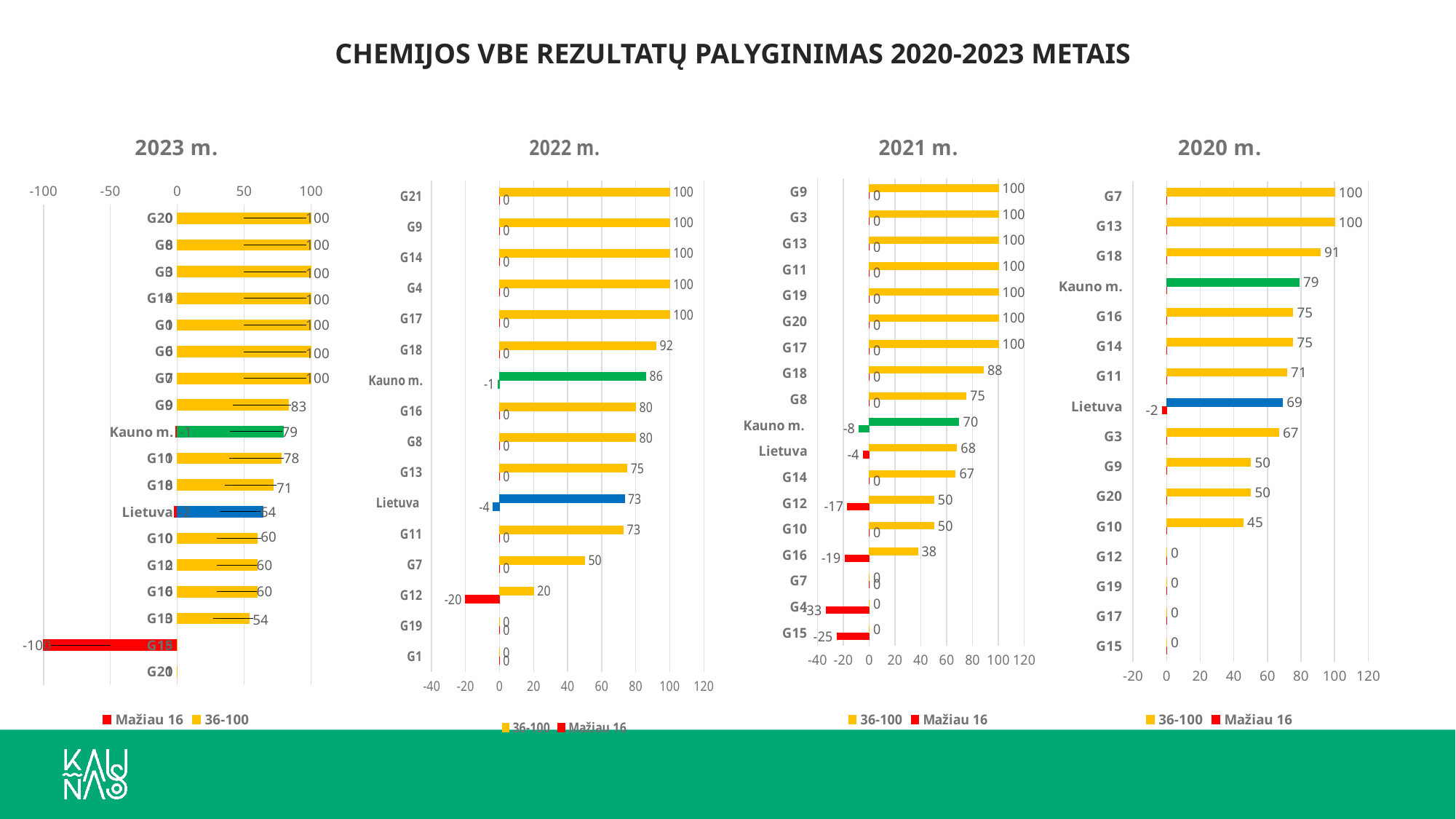
In the 2022 m. chart, which category has the lowest negative (Mažiau 16) value? G12 In the 2021 m. chart, what is the value for G16? 38 In the 2022 m. chart, what is the value for Kauno m.? 86 How many series does the legend of the 2020 m. chart list? 2 In the 2020 m. chart, what is the value for Lietuva? 69 In the 2021 m. chart, what is the negative (Mažiau 16) value shown for G4? -33 In the 2020 m. chart, what is the value for Kauno m.? 79 In the 2021 m. chart, which is larger, the value for Kauno m. or the value for Lietuva? Kauno m. In the 2020 m. chart, what is the value for G18? 91 What kind of chart is the 2021 m. chart? Bar chart In the 2022 m. chart, what is the difference between the values for G18 and G7? 42 In the 2020 m. chart, what is the difference between the values for G7 and G10? 55